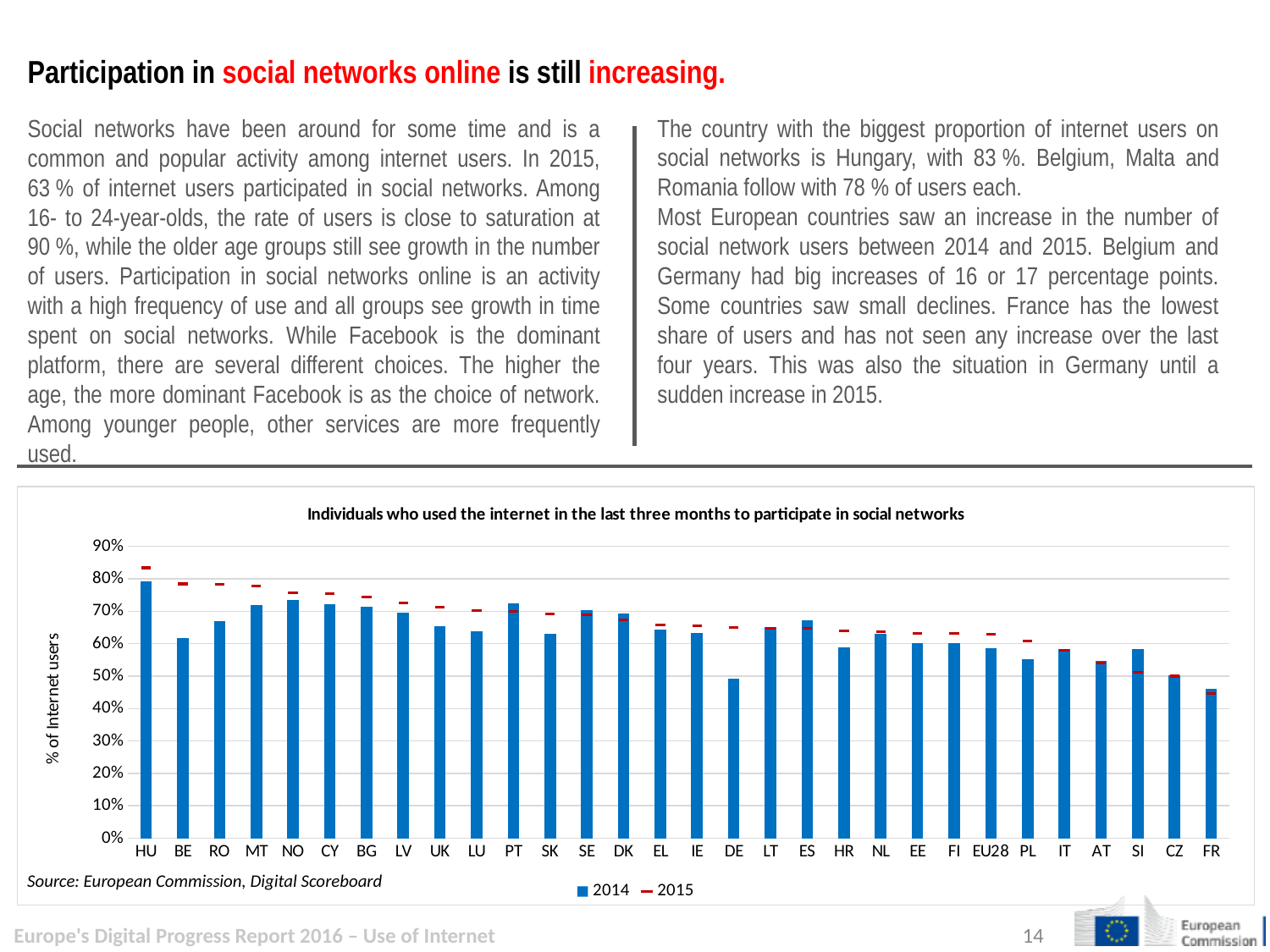
Which country has the lowest 2015 value in the chart? FR How many countries/categories are shown on the x axis of the chart? 30 How many series does the chart legend list? 2 What is the label on the y axis of the chart? % of Internet users Is the 2015 value for FR greater or less than 50%? less For DE, which is larger: the 2014 value or the 2015 value? 2015 Is the 2014 value for HU greater or less than 70%? greater What type of chart is shown on the slide? bar chart Which country has the tallest 2014 bar in the chart? HU Which country has the highest 2015 value in the chart? HU Is the 2015 value for BE greater or less than 70%? greater